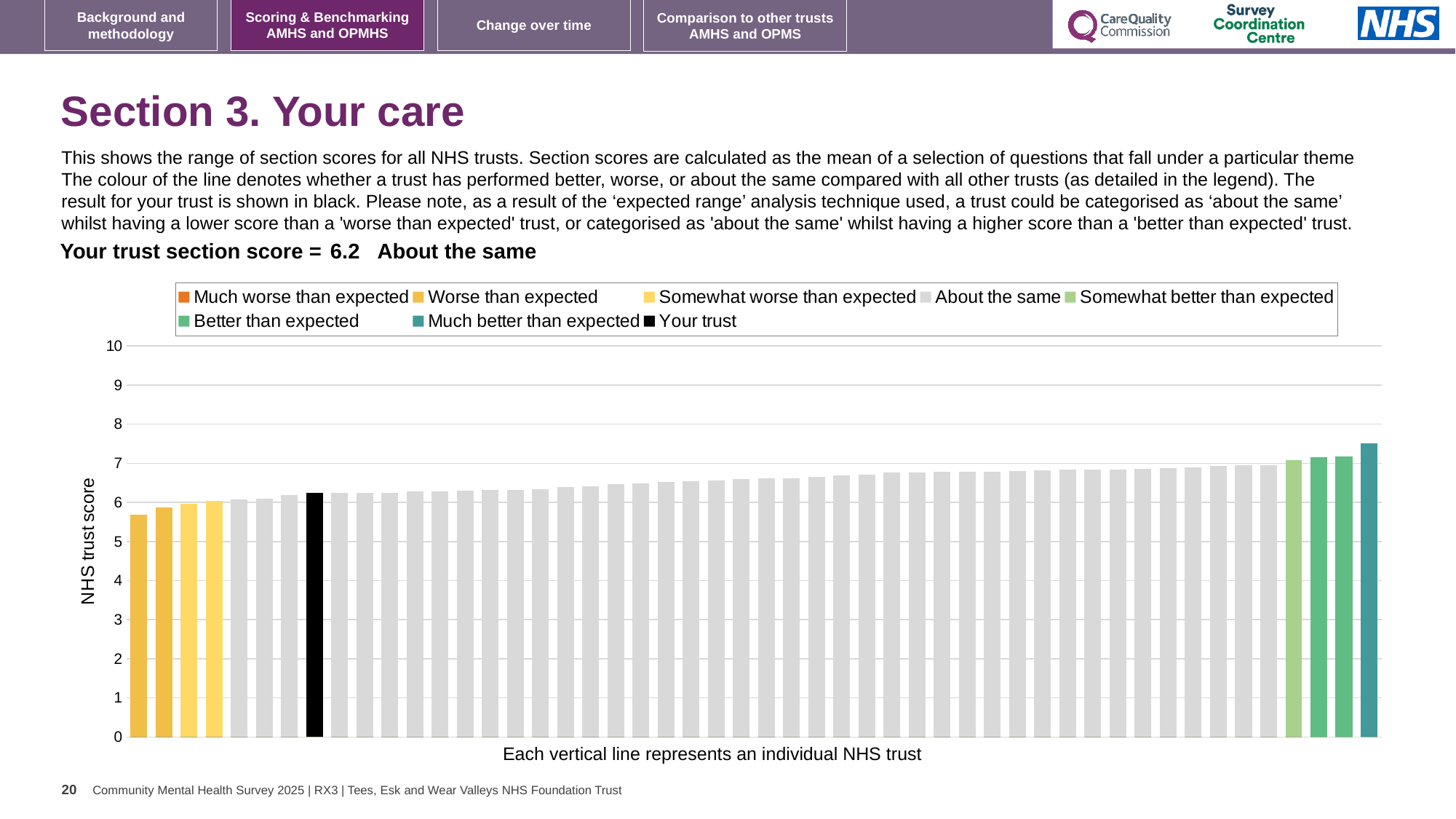
What is the label on the vertical axis of the chart? NHS trust score Is the value of the rightmost bar greater or less than 7? greater Do the bar values rise or fall from left to right along the x axis? rise Which legend category does the highest bar belong to? Much better than expected What colour is the bar representing your trust? black Which is larger, the leftmost bar or the rightmost bar? the rightmost bar Is the value of the black 'Your trust' bar greater or less than 5? greater How many entries does the chart legend list? 8 What kind of chart is shown on the slide? bar chart Is the value of the leftmost bar greater or less than 6? less What is the section score for your trust shown on the slide? 6.2